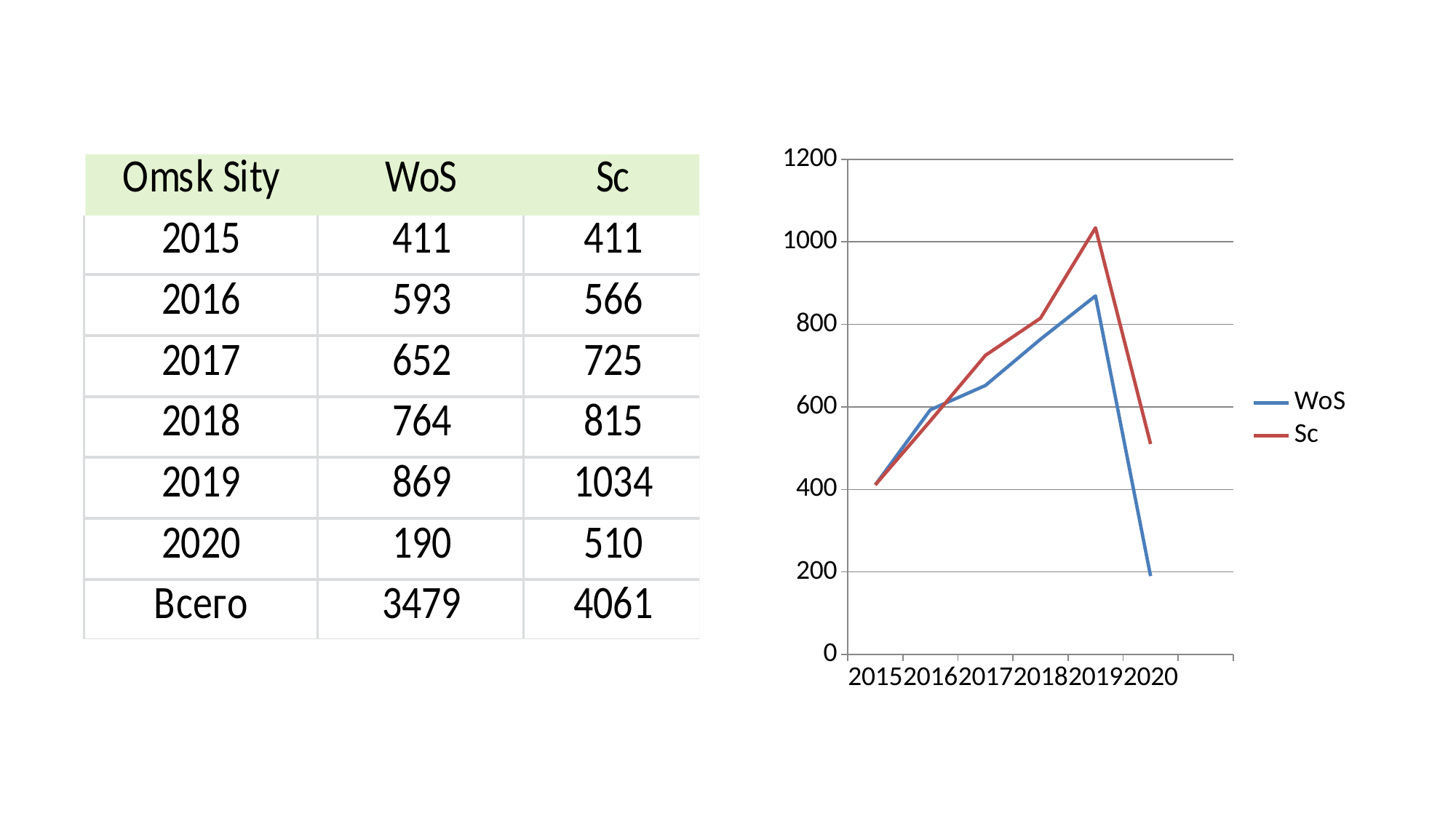
What type of chart is shown on the slide? line chart What is the WoS value for 2019? 869 Which series has the larger value in 2020, WoS or Sc? Sc In which year does the Sc series reach its highest value? 2019 Does the WoS series rise or fall from 2015 to 2019? rise How many years are plotted along the x axis of the chart? 6 Is the Sc value for 2019 greater or less than 1000? greater What is the difference between the Sc and WoS values in 2019? 165 What is the Sc value for 2020? 510 In which year is the WoS series at its lowest? 2020 Which colour is used for the Sc series in the chart? red How many series does the chart legend list? 2